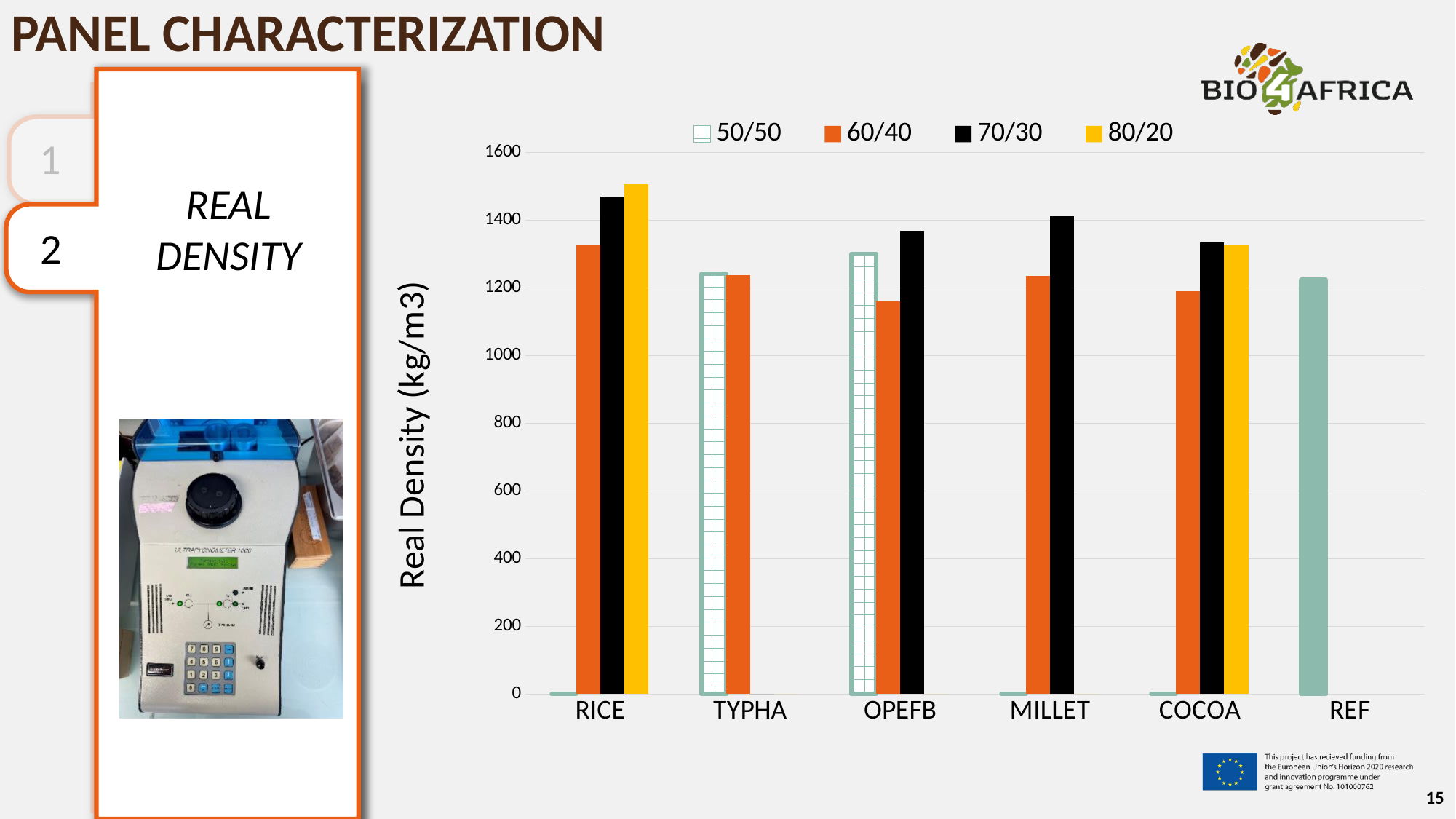
Which category has the highest 80/20 value? RICE For RICE, which is larger: the 80/20 value or the 60/40 value? 80/20 How many categories are shown on the x axis of the chart? 6 What kind of chart is shown on the slide? bar chart Which category has the highest 70/30 value? RICE How many series does the chart legend list? 4 Is the 60/40 value for OPEFB greater or less than 1200? less Is the value for REF greater or less than 1400? less Is the 80/20 value for RICE greater or less than 1400? greater For OPEFB, which is larger: the 70/30 value or the 60/40 value? 70/30 What is the title of the y axis of the chart? Real Density (kg/m3)